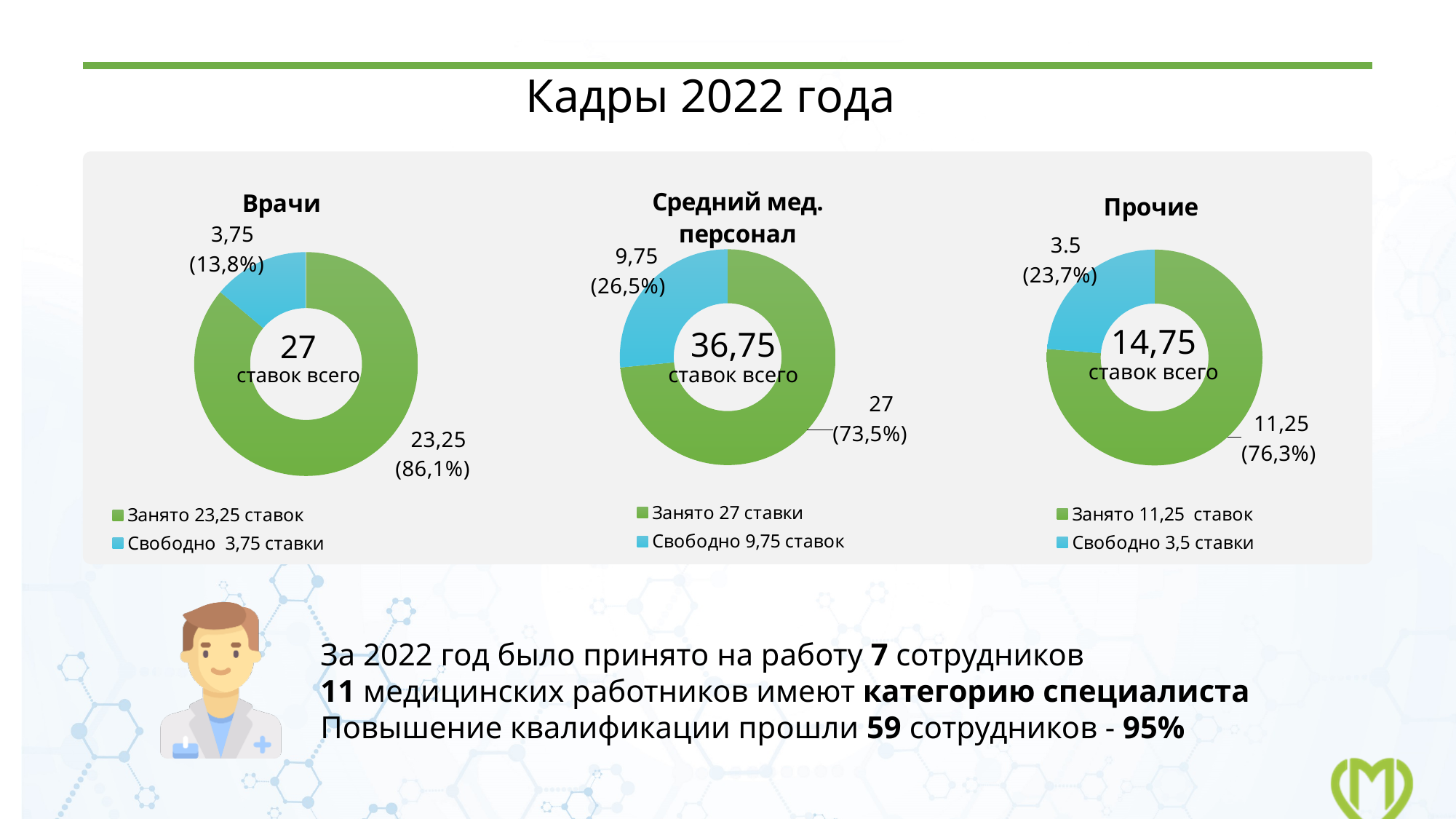
What total number of positions ('ставок всего') is shown in the centre of the 'Средний мед. персонал' chart? 36,75 In the 'Прочие' chart, what share of the total does the 'Свободно' slice represent? 23,7% In the 'Прочие' chart, what value is shown for the 'Занято' slice? 11,25 In the 'Врачи' chart, what share of the total does the 'Свободно' slice represent? 13,8% In the 'Средний мед. персонал' chart, what value is shown for the 'Свободно' slice? 9,75 What kind of chart is used for 'Врачи'? Doughnut chart How many entries does the legend of the 'Прочие' chart list? 2 In the 'Средний мед. персонал' chart, what share of the total does the 'Занято' slice represent? 73,5% In the 'Средний мед. персонал' chart, what is the difference between the 'Занято' and 'Свободно' values? 17,25 In the 'Врачи' chart, what value is shown for the 'Занято' slice? 23,25 What total number of positions ('ставок всего') is shown in the centre of the 'Прочие' chart? 14,75 In the 'Врачи' chart, which slice is larger, 'Занято' or 'Свободно'? Занято